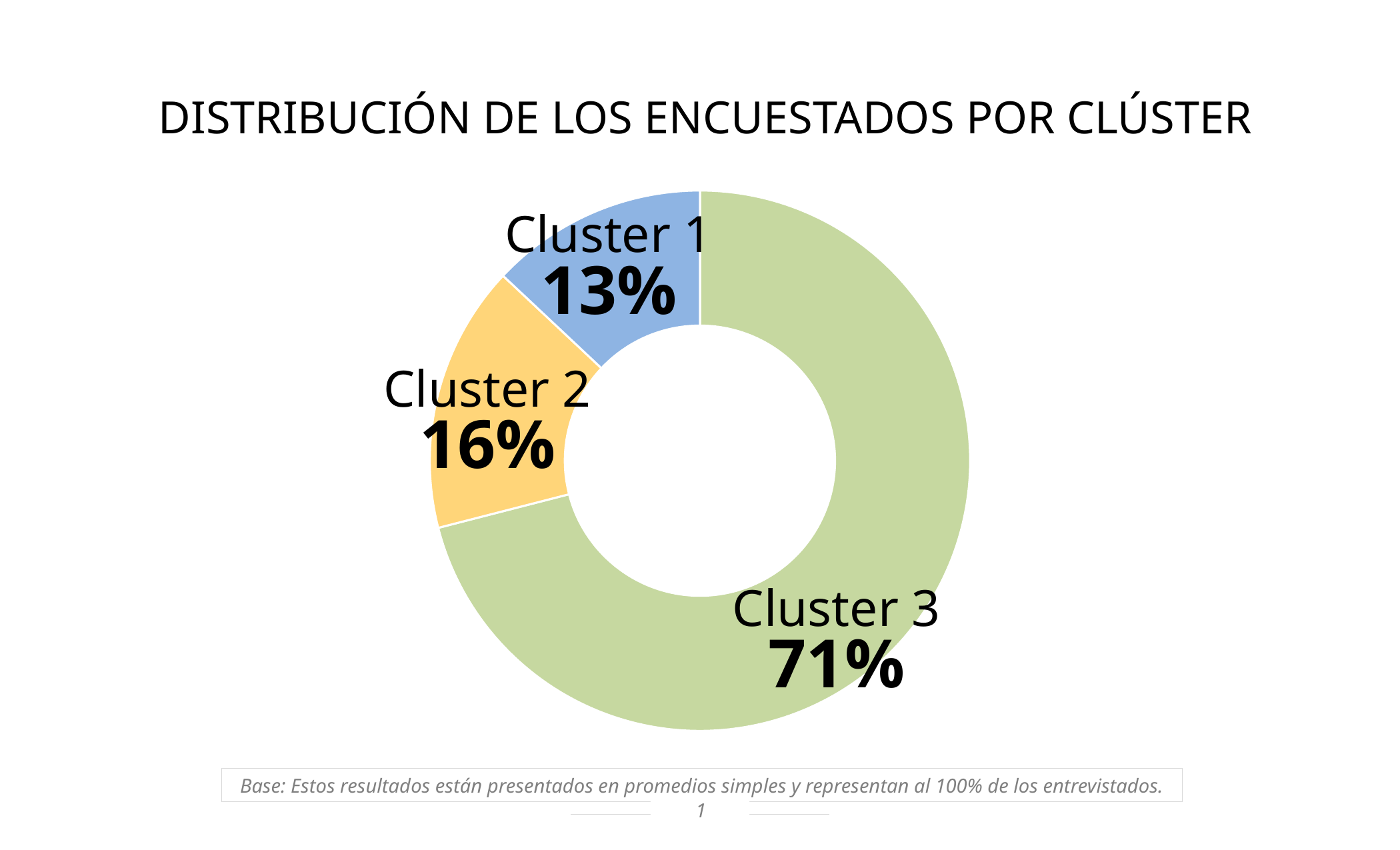
What colour is the Cluster 3 segment? Green What percentage of respondents are in Cluster 2? 16% What is the difference in percentage points between Cluster 3 and Cluster 2? 55 Which has a larger share, Cluster 1 or Cluster 2? Cluster 2 Which cluster has the smallest share of respondents? Cluster 1 What type of chart is shown on the slide? Doughnut chart What is the title of the chart? DISTRIBUCIÓN DE LOS ENCUESTADOS POR CLÚSTER Which cluster has the largest share of respondents? Cluster 3 How many clusters are shown in the chart? 3 What percentage of respondents are in Cluster 3? 71% What percentage of respondents are in Cluster 1? 13% What is the difference in percentage points between Cluster 2 and Cluster 1? 3